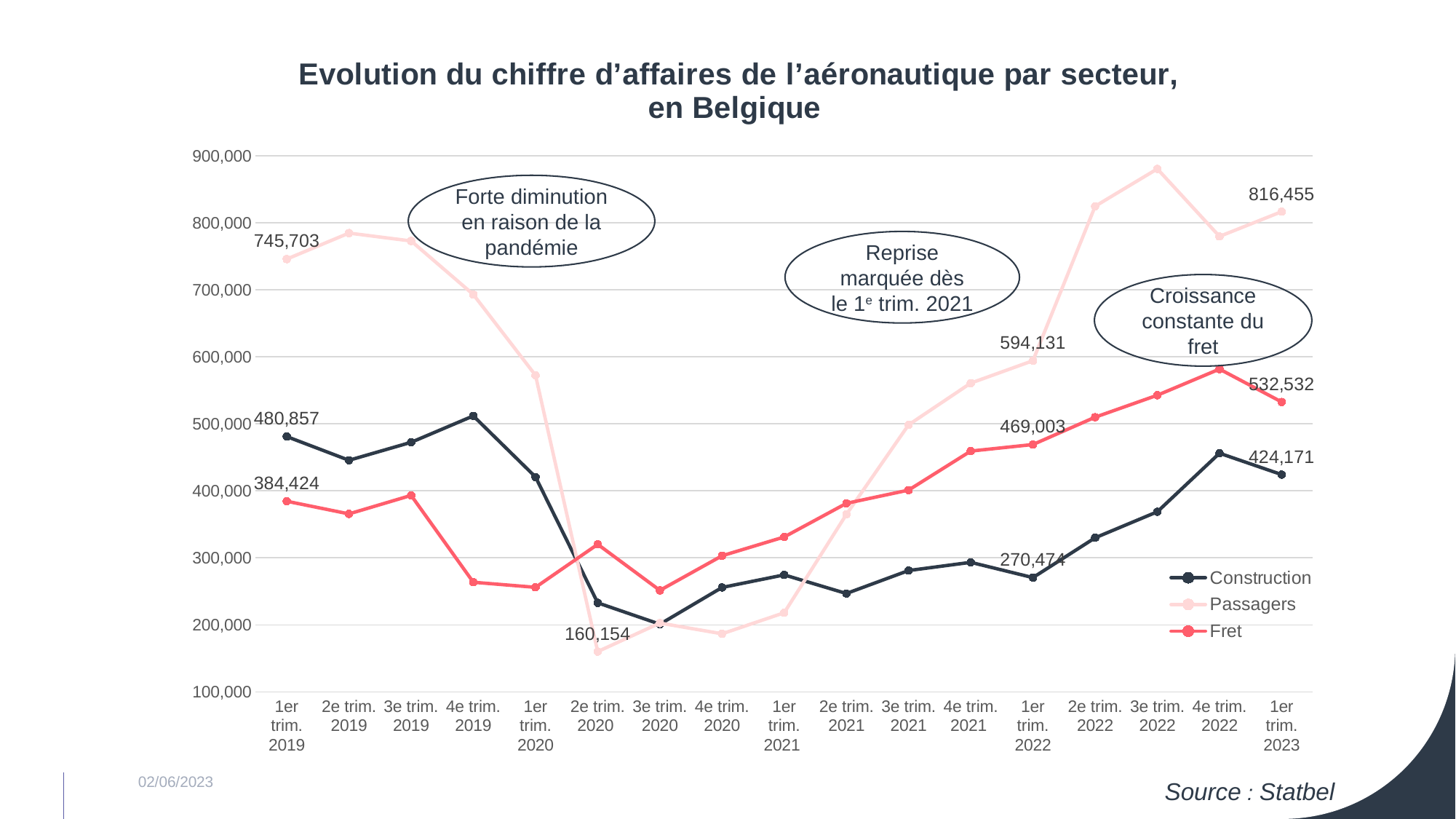
How many series does the legend list? 3 In 1er trim. 2023, which is larger: Construction or Fret? Fret Is the value for Passagers in 3e trim. 2022 greater or less than 800,000? greater How many quarters are shown on the x axis? 17 What is the value for Passagers in 1er trim. 2019? 745,703 In which quarter does the Passagers series reach its lowest point? 2e trim. 2020 What is the difference between the Fret value in 1er trim. 2023 and in 1er trim. 2019? 148,108 What is the value for Passagers in 2e trim. 2020? 160,154 What is the value for Construction in 1er trim. 2023? 424,171 What is the difference between the Passagers value in 1er trim. 2023 and in 1er trim. 2019? 70,752 What kind of chart is shown on the slide? line chart What is the value for Fret in 1er trim. 2022? 469,003